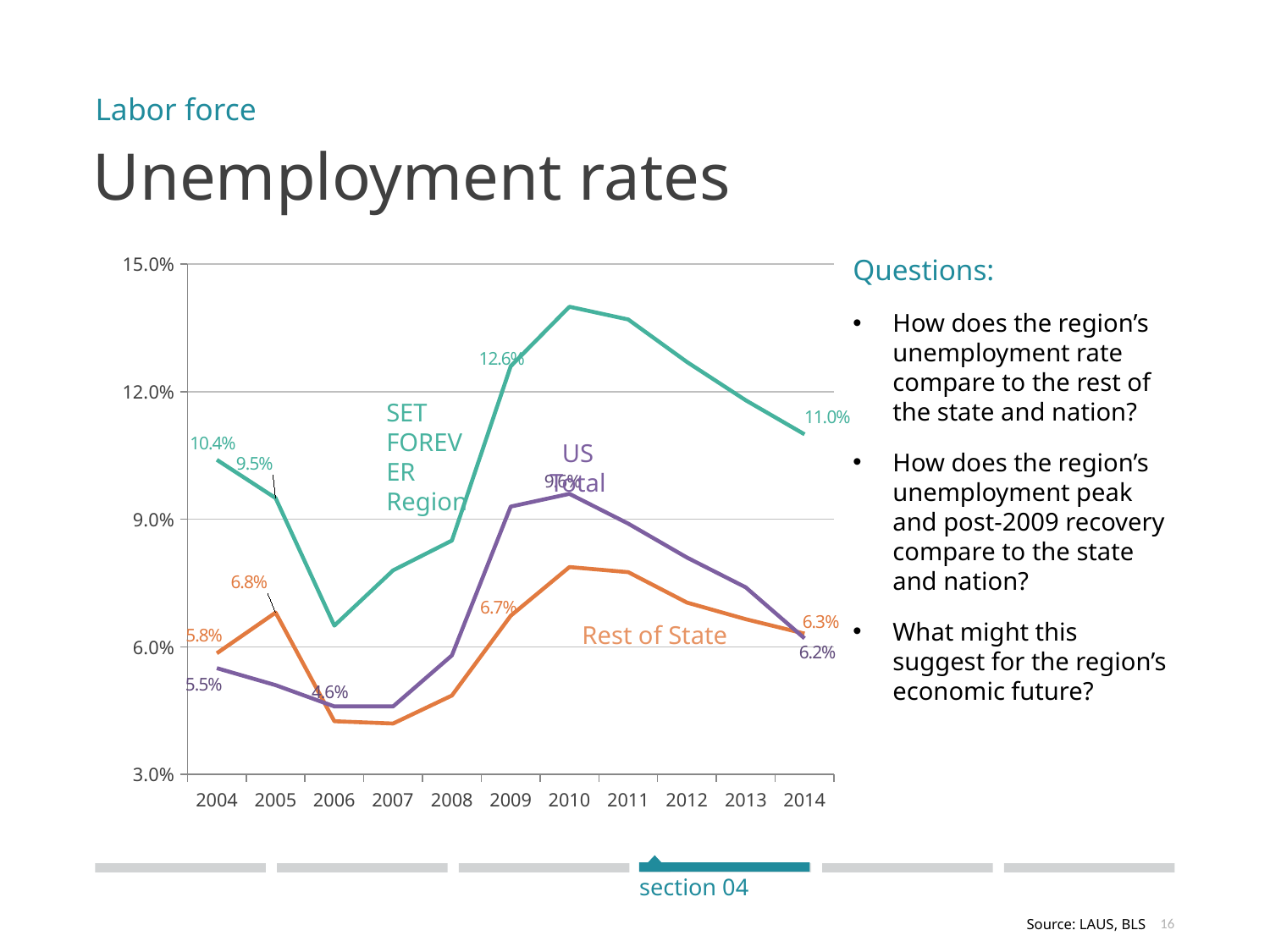
Is the SET FOREVER Region unemployment rate in 2010 greater or less than 12.0%? greater How many years are shown on the x axis? 11 What was the SET FOREVER Region unemployment rate in 2004? 10.4% What kind of chart is shown on the slide? Line chart What was the SET FOREVER Region unemployment rate in 2014? 11.0% How many series are plotted on the chart? 3 What was the SET FOREVER Region unemployment rate in 2009? 12.6% By how many percentage points did the SET FOREVER Region unemployment rate change between 2004 (10.4%) and 2014 (11.0%)? 0.6 percentage points What was the US Total unemployment rate in 2014? 6.2% What was the US Total unemployment rate in 2006? 4.6% What was the Rest of State unemployment rate in 2005? 6.8% Which series had the highest unemployment rate in 2010? SET FOREVER Region